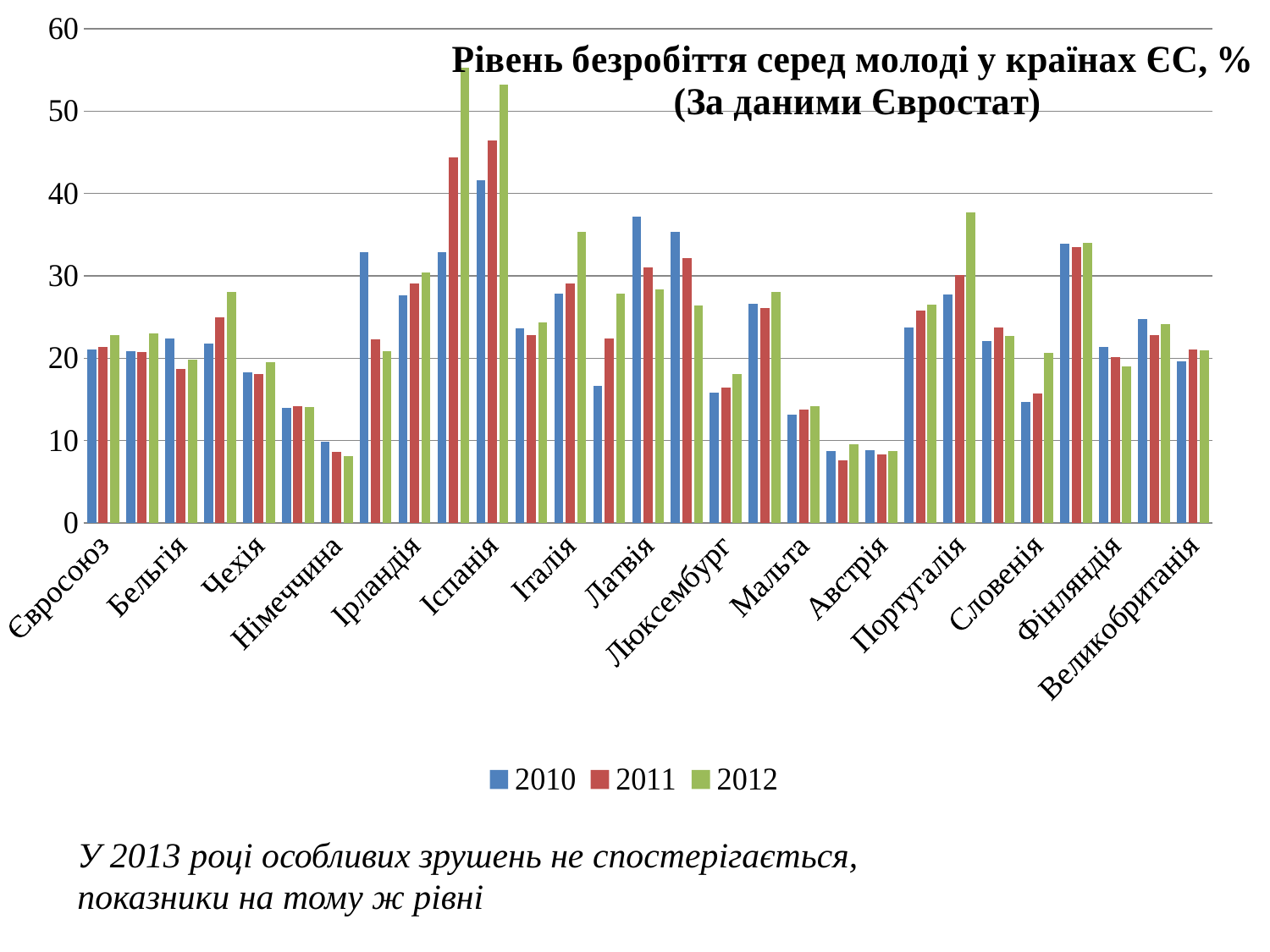
For Іспанія, which year has the highest bar? 2012 Is the 2012 value for Іспанія greater or less than 50? greater What is the title of the chart? Рівень безробіття серед молоді у країнах ЄС, % (За даними Євростат) Is the 2011 value for Австрія greater or less than 10? less For Латвія, which year has the highest bar? 2010 How many series does the legend list? 3 What kind of chart is shown on the slide? bar chart Is the 2011 value for Ірландія greater or less than 20? greater Which is larger, the 2012 value for Іспанія or the 2012 value for Австрія? Іспанія Which years are listed in the legend? 2010, 2011, 2012 Do the values for Іспанія rise or fall from 2010 to 2012? rise